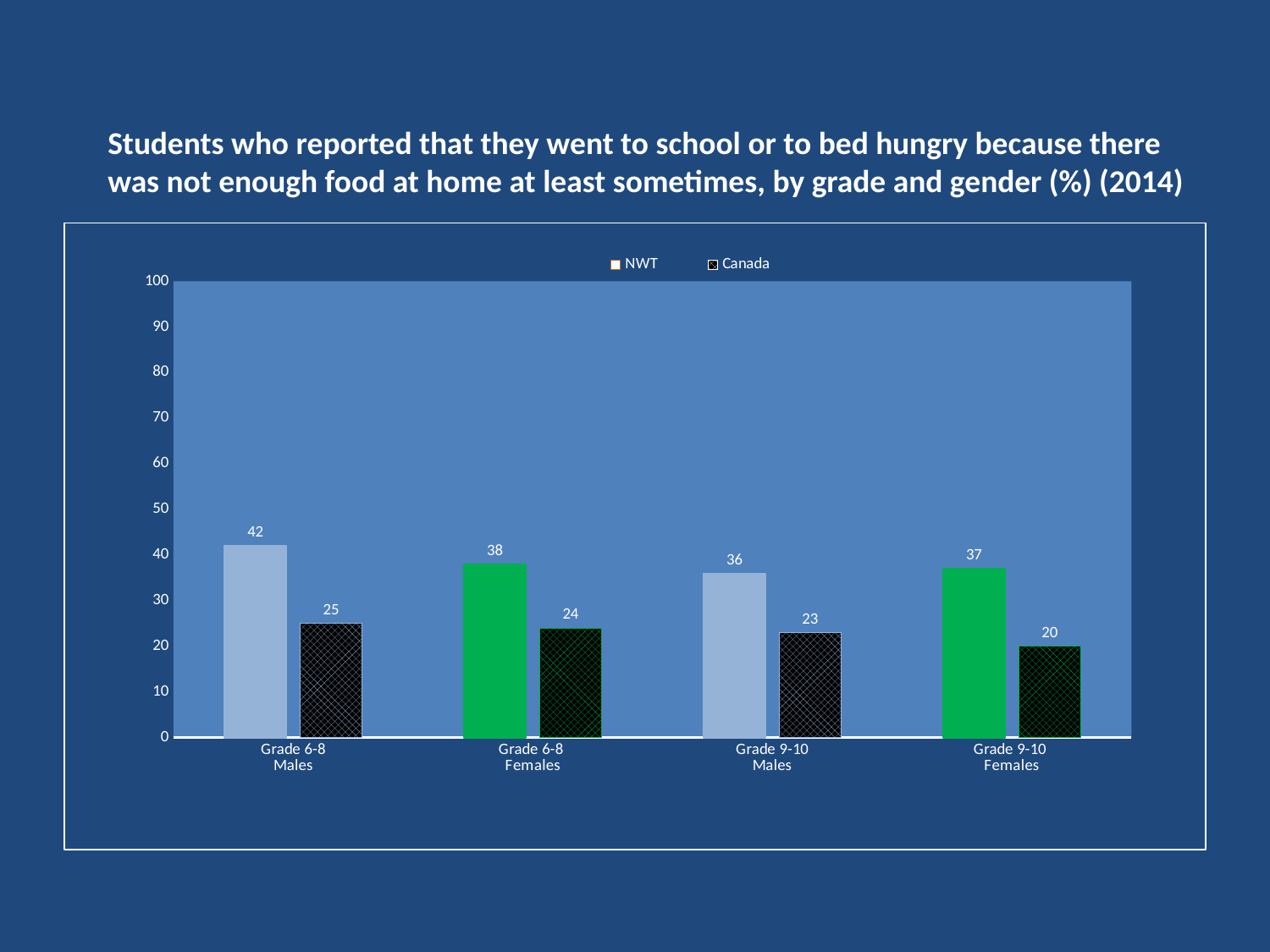
What is the difference between the NWT and Canada values for Grade 6-8 Females? 14 What is the NWT value for Grade 6-8 Males? 42 How many series does the legend list? 2 What are the two series named in the legend? NWT and Canada What is the NWT value for Grade 9-10 Males? 36 Which is larger for Grade 9-10 Males, the NWT value or the Canada value? NWT Which category has the highest NWT value? Grade 6-8 Males What kind of chart is shown on the slide? bar chart What is the Canada value for Grade 9-10 Females? 20 How many categories are shown on the x axis? 4 Which category has the lowest Canada value? Grade 9-10 Females Is the NWT value for Grade 9-10 Females greater or less than 30? greater